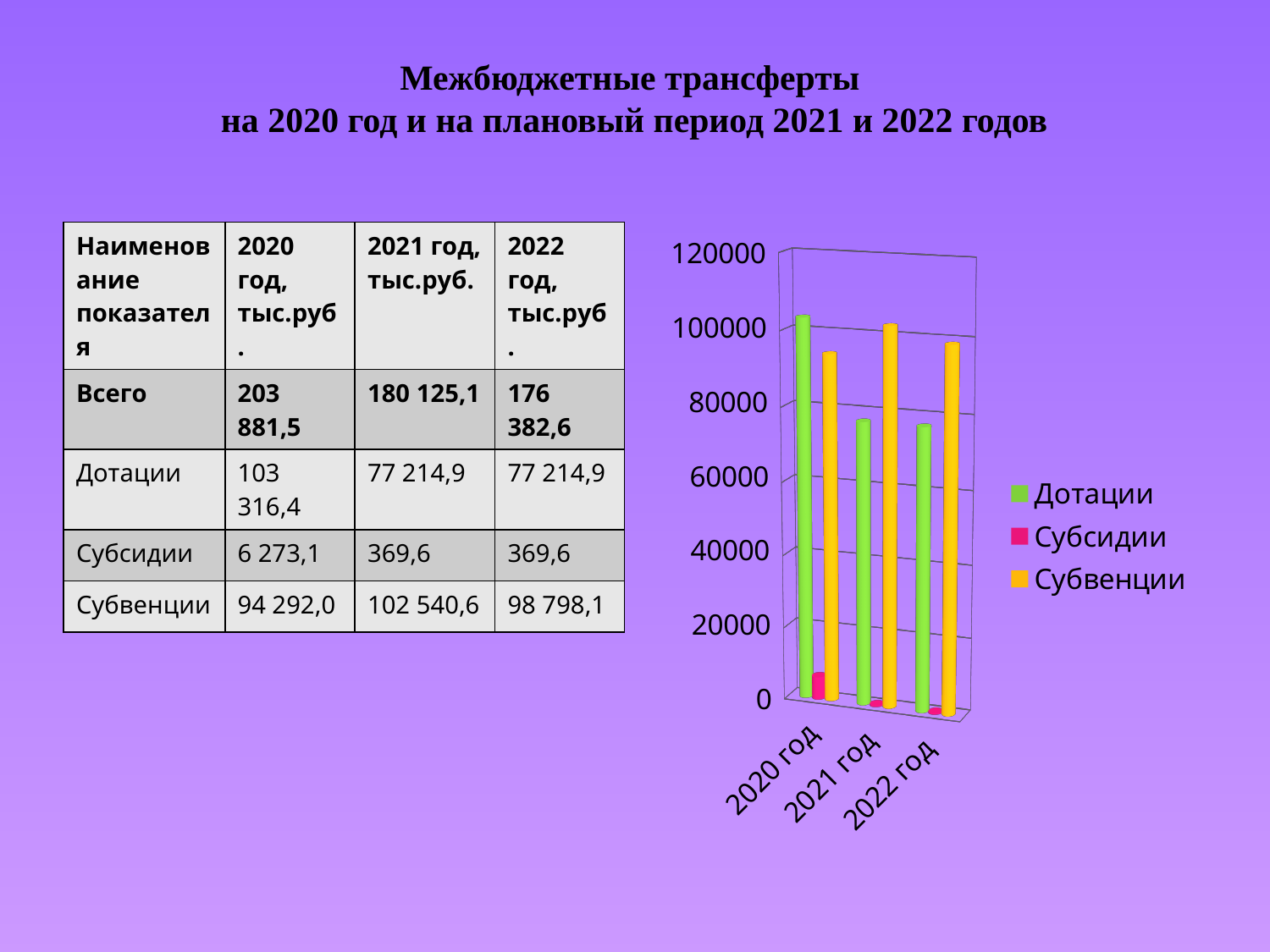
Do the Дотации bars rise or fall from 2020 год to 2021 год? fall Is the Субвенции bar for 2020 год greater or less than 100000? less Which series is shown in yellow in the chart legend? Субвенции What kind of chart is shown on the slide? bar chart Which series has the shortest bar for 2020 год? Субсидии Which series has the tallest bar for 2020 год? Дотации Is the Дотации bar for 2021 год greater or less than 80000? less How many year categories are shown on the x axis of the chart? 3 For 2021 год, which is larger: Дотации or Субвенции? Субвенции How many series does the chart legend list? 3 Is the Субсидии bar for 2020 год greater or less than 20000? less